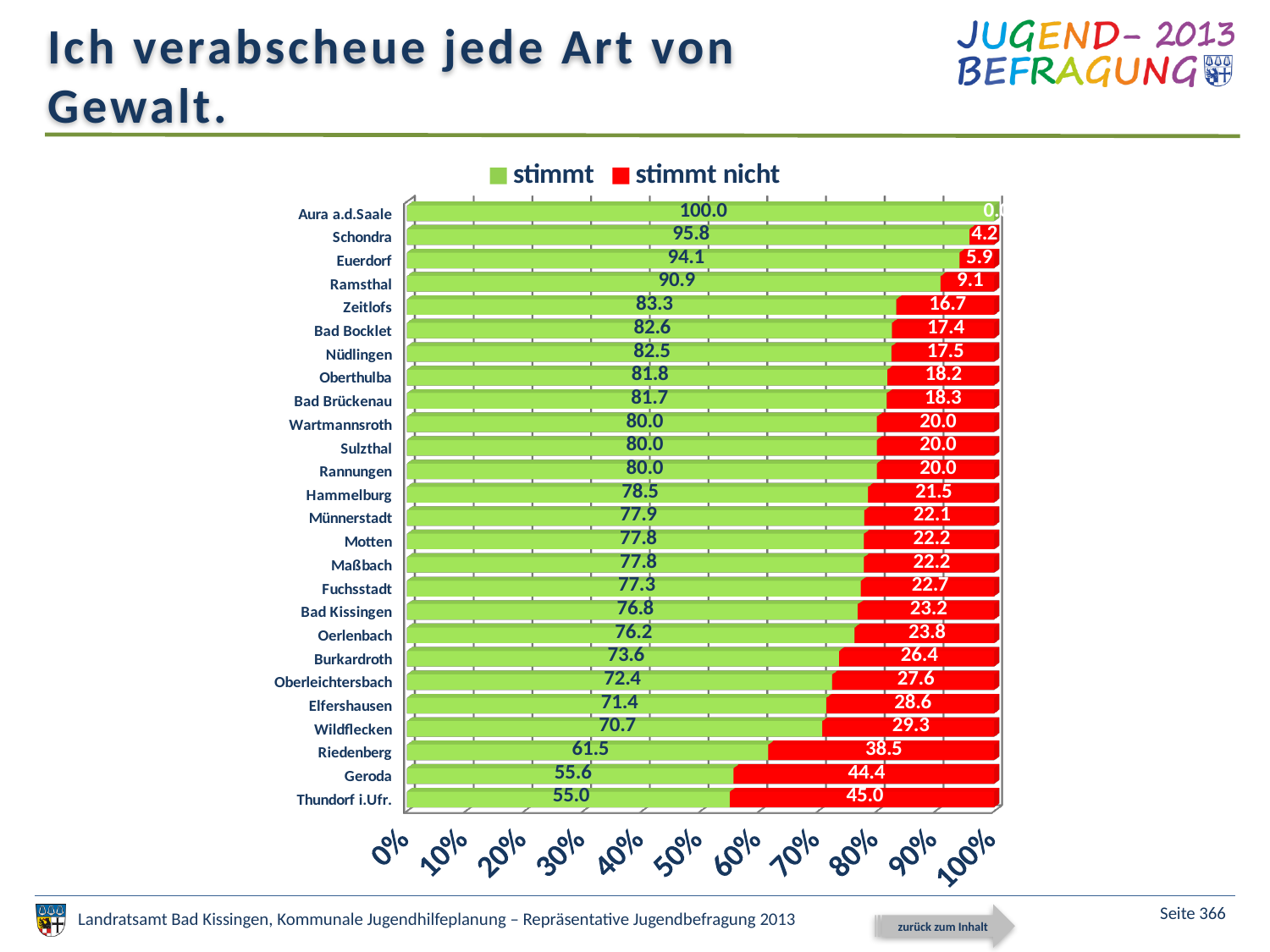
How many municipalities are shown in the chart? 26 What is the value of "stimmt nicht" for Wildflecken? 29.3 What is the value of "stimmt" for Schondra? 95.8 What is the total of the stacked bar for Euerdorf? 100.0 Which has the larger "stimmt" value, Zeitlofs or Bad Bocklet? Zeitlofs What is the difference between the "stimmt" values of Geroda and Thundorf i.Ufr.? 0.6 Which municipality has the lowest "stimmt" value? Thundorf i.Ufr. What kind of chart is shown on the slide? Stacked bar chart What is the difference between the "stimmt nicht" values of Geroda and Riedenberg? 5.9 Which municipality has the highest "stimmt" value? Aura a.d.Saale What is the value of "stimmt nicht" for Riedenberg? 38.5 How many series does the legend list? 2